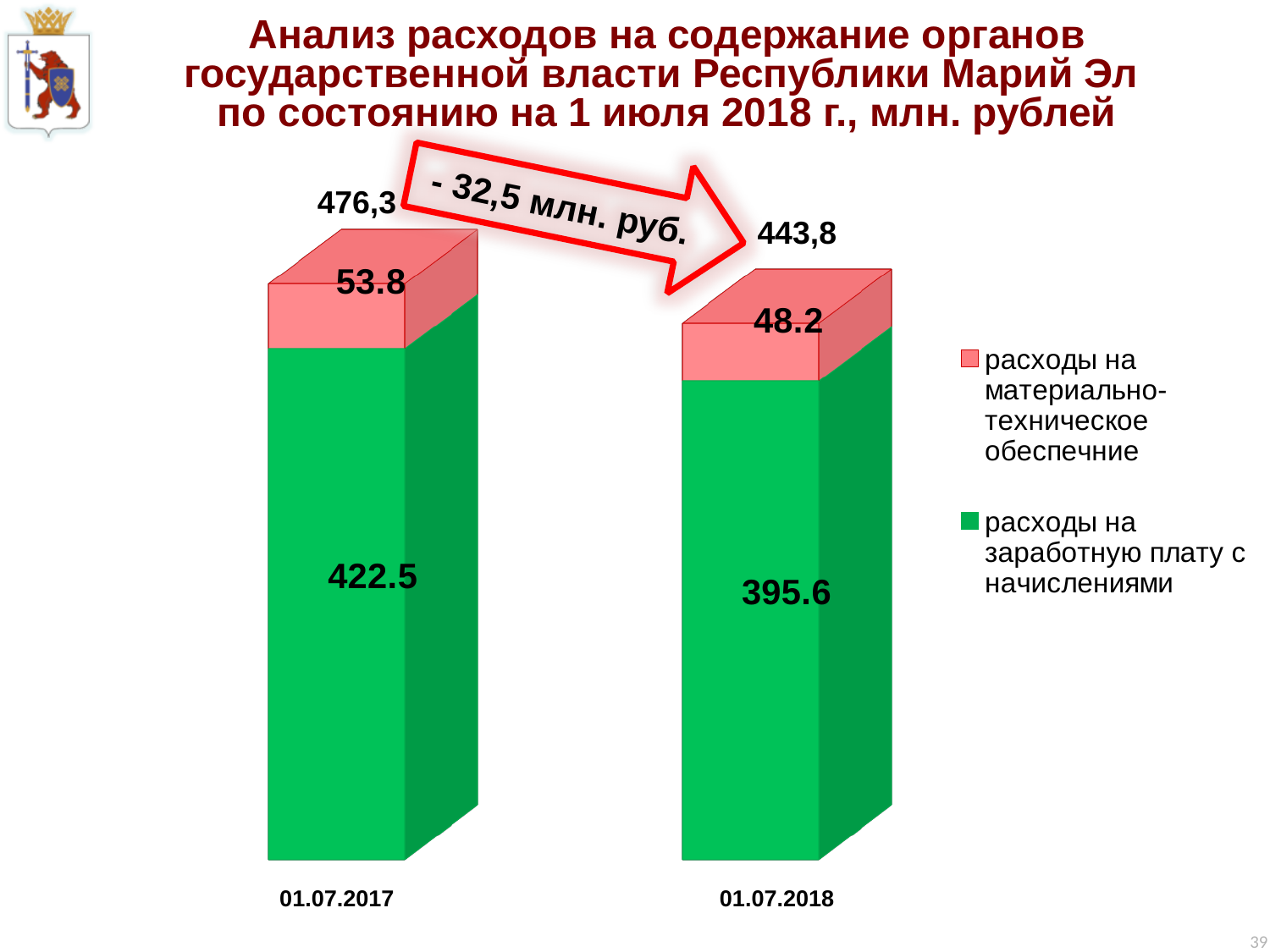
What is the total shown above the stacked bar for 01.07.2018? 443,8 How many categories (dates) are shown on the x axis of the chart? 2 What is the value for 'расходы на материально-техническое обеспечние' for 01.07.2017? 53.8 What is the value for 'расходы на материально-техническое обеспечние' for 01.07.2018? 48.2 What is the total shown above the stacked bar for 01.07.2017? 476,3 What is the value for 'расходы на заработную плату с начислениями' for 01.07.2017? 422.5 What kind of chart is shown on the slide? Stacked bar chart What is the difference between the 'расходы на заработную плату с начислениями' values for 01.07.2017 and 01.07.2018? 26.9 What is the value for 'расходы на заработную плату с начислениями' for 01.07.2018? 395.6 Which date has the higher value for 'расходы на заработную плату с начислениями', 01.07.2017 or 01.07.2018? 01.07.2017 What is the difference between the 'расходы на материально-техническое обеспечние' values for 01.07.2017 and 01.07.2018? 5.6 How many series does the legend list? 2